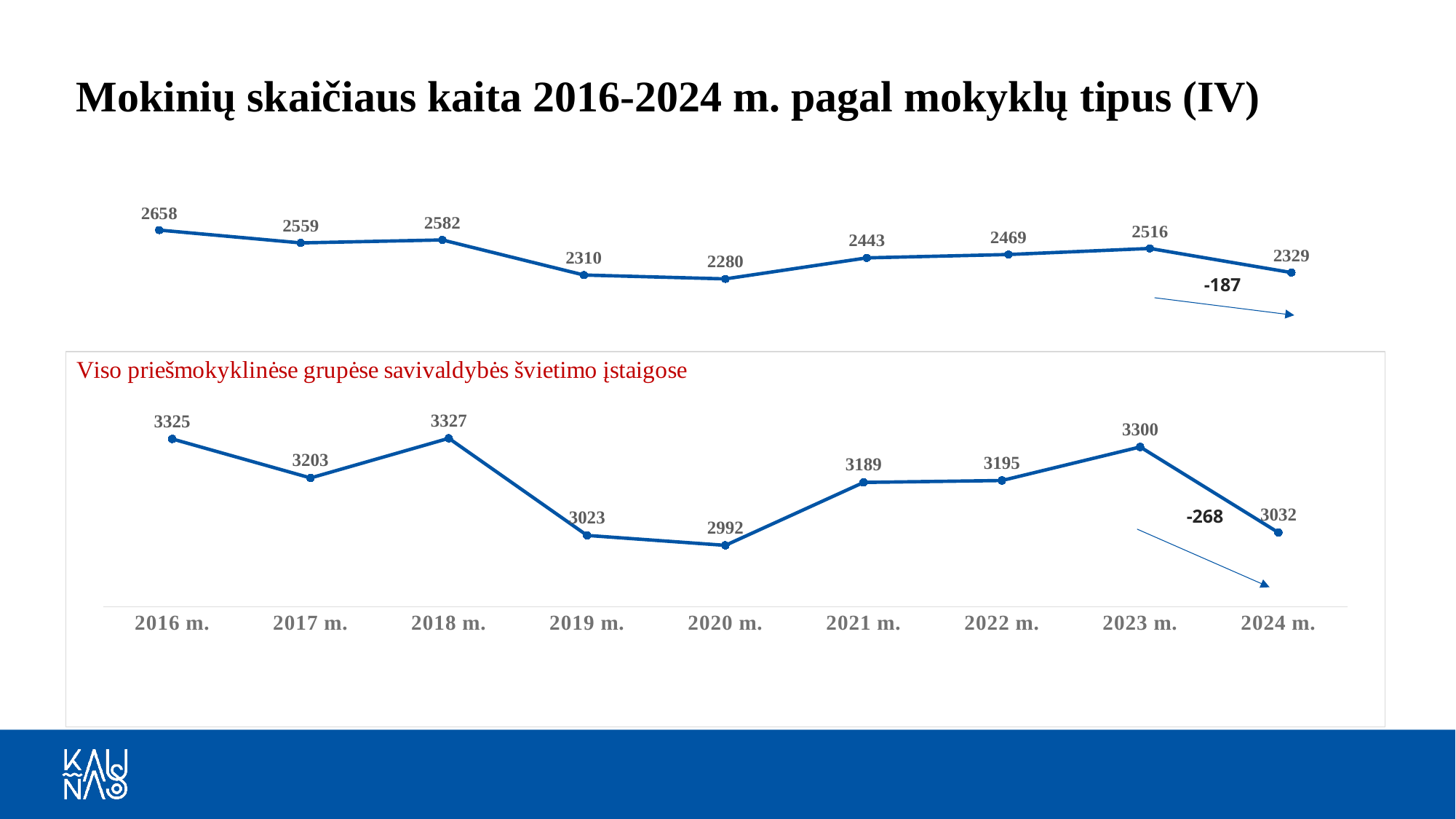
In the top chart, what is the difference between the values for 2023 m. and 2024 m.? 187 In the bottom chart titled 'Viso priešmokyklinėse grupėse savivaldybės švietimo įstaigose', which year has the lowest value? 2020 m. In the bottom chart titled 'Viso priešmokyklinėse grupėse savivaldybės švietimo įstaigose', what is the value for 2016 m.? 3325 How many data points does the bottom chart titled 'Viso priešmokyklinėse grupėse savivaldybės švietimo įstaigose' have? 9 In the top chart, what is the value for 2020 m.? 2280 In the bottom chart titled 'Viso priešmokyklinėse grupėse savivaldybės švietimo įstaigose', what is the difference between the values for 2023 m. and 2024 m.? 268 In the bottom chart titled 'Viso priešmokyklinėse grupėse savivaldybės švietimo įstaigose', which year has the highest value? 2018 m. In the top chart, what is the value for 2023 m.? 2516 In the top chart, which is larger: the value for 2017 m. or the value for 2018 m.? 2018 m. In the bottom chart titled 'Viso priešmokyklinėse grupėse savivaldybės švietimo įstaigose', what is the value for 2024 m.? 3032 In the top chart, which year has the highest value? 2016 m. In the top chart, which year has the lowest value? 2020 m.